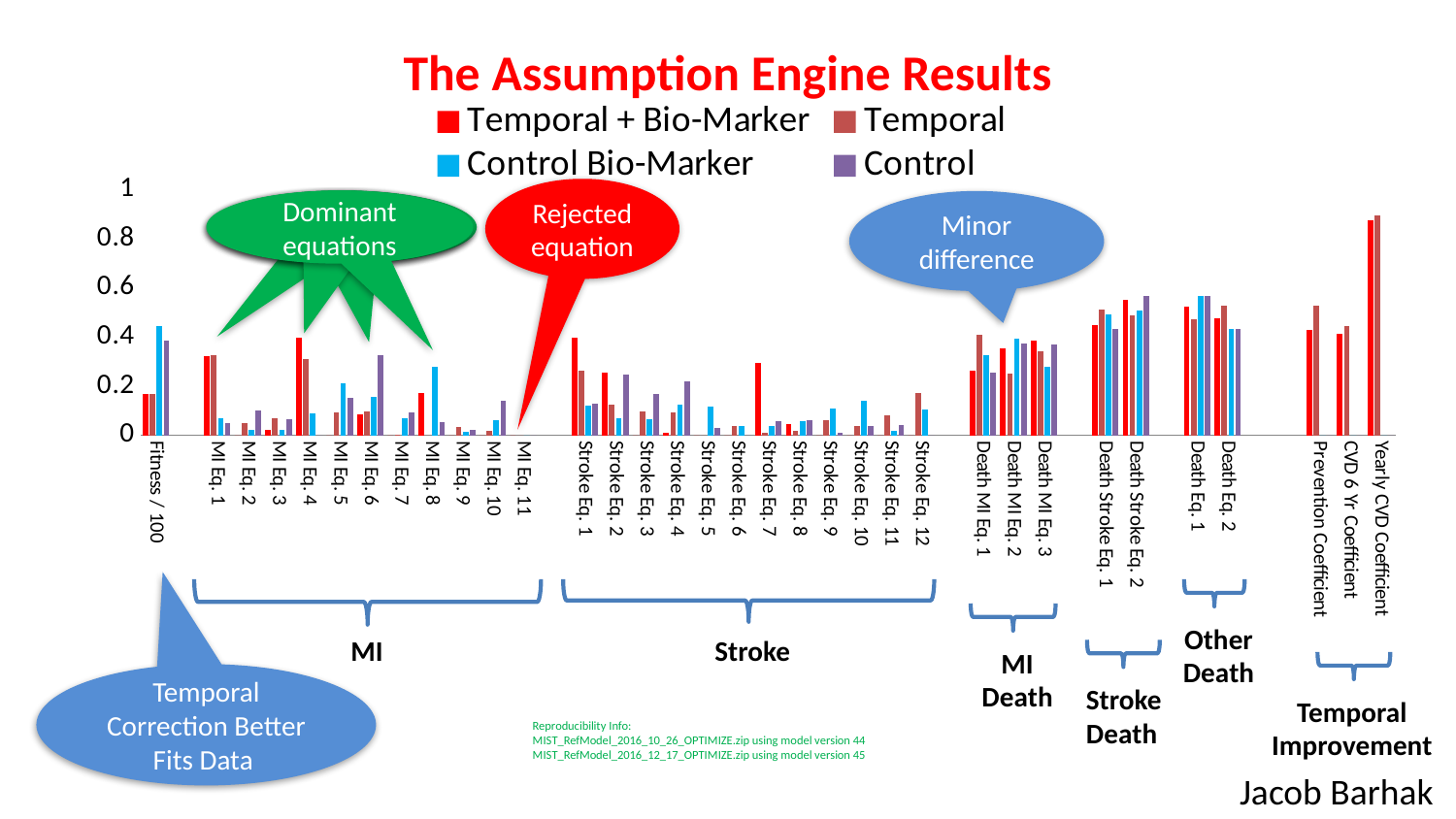
Which series is shown in bright red in the legend? Temporal + Bio-Marker Which category has the tallest bars in the chart? Yearly CVD Coefficient For the Temporal series, which is larger: Yearly CVD Coefficient or Prevention Coefficient? Yearly CVD Coefficient Is the Temporal + Bio-Marker value for MI Eq. 11 greater or less than 0.2? less Is the Temporal + Bio-Marker value for Stroke Eq. 7 greater or less than 0.2? greater How many series does the legend list? 4 What kind of chart is shown on the slide? bar chart For the Control Bio-Marker series, which is larger: Death Eq. 1 or MI Eq. 1? Death Eq. 1 What is the title of the chart? The Assumption Engine Results Is the Control value for Death Stroke Eq. 2 greater or less than 0.4? greater